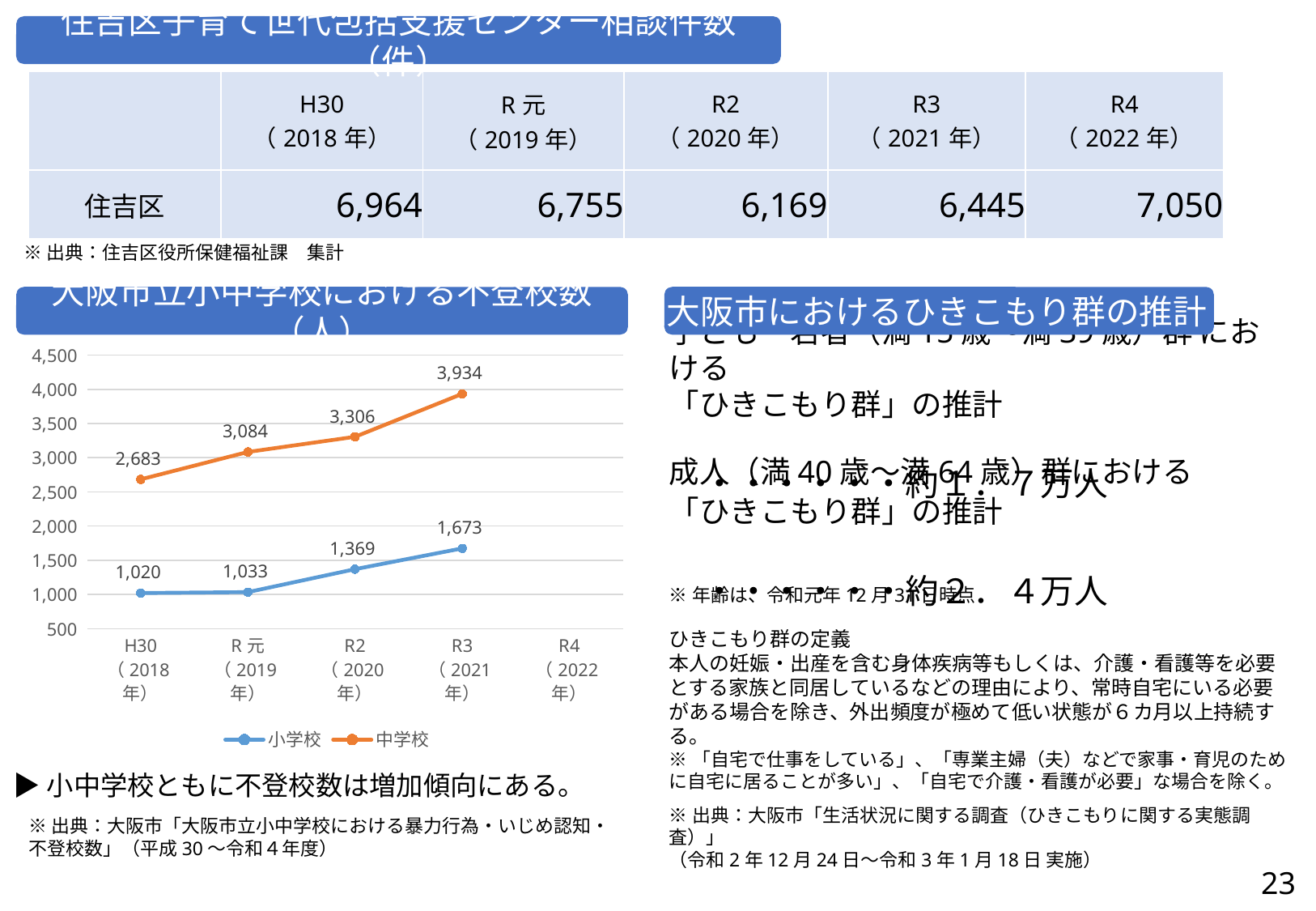
In the 不登校数 chart, which year has the lowest value for 中学校? H30（2018年） In the 不登校数 chart, what is the value for 小学校 in R2（2020年）? 1,369 In the 不登校数 chart, what is the difference between the 中学校 and 小学校 values in R3（2021年）? 2,261 In the 不登校数 chart, which year has the highest value for 小学校? R3（2021年） In the 不登校数 chart, which series has the larger value in R2（2020年）, 小学校 or 中学校? 中学校 In the 不登校数 chart, do the 中学校 values rise or fall from H30 to R3? rise What type of chart is used to show 大阪市立小中学校における不登校数? line chart In the 不登校数 chart, which colour is used for the 中学校 line? orange In the 不登校数 chart, what is the value for 中学校 in R3（2021年）? 3,934 In the 不登校数 chart, what is the value for 中学校 in R元（2019年）? 3,084 How many series does the legend of the 不登校数 chart list? 2 In the 不登校数 chart, what is the value for 小学校 in H30（2018年）? 1,020